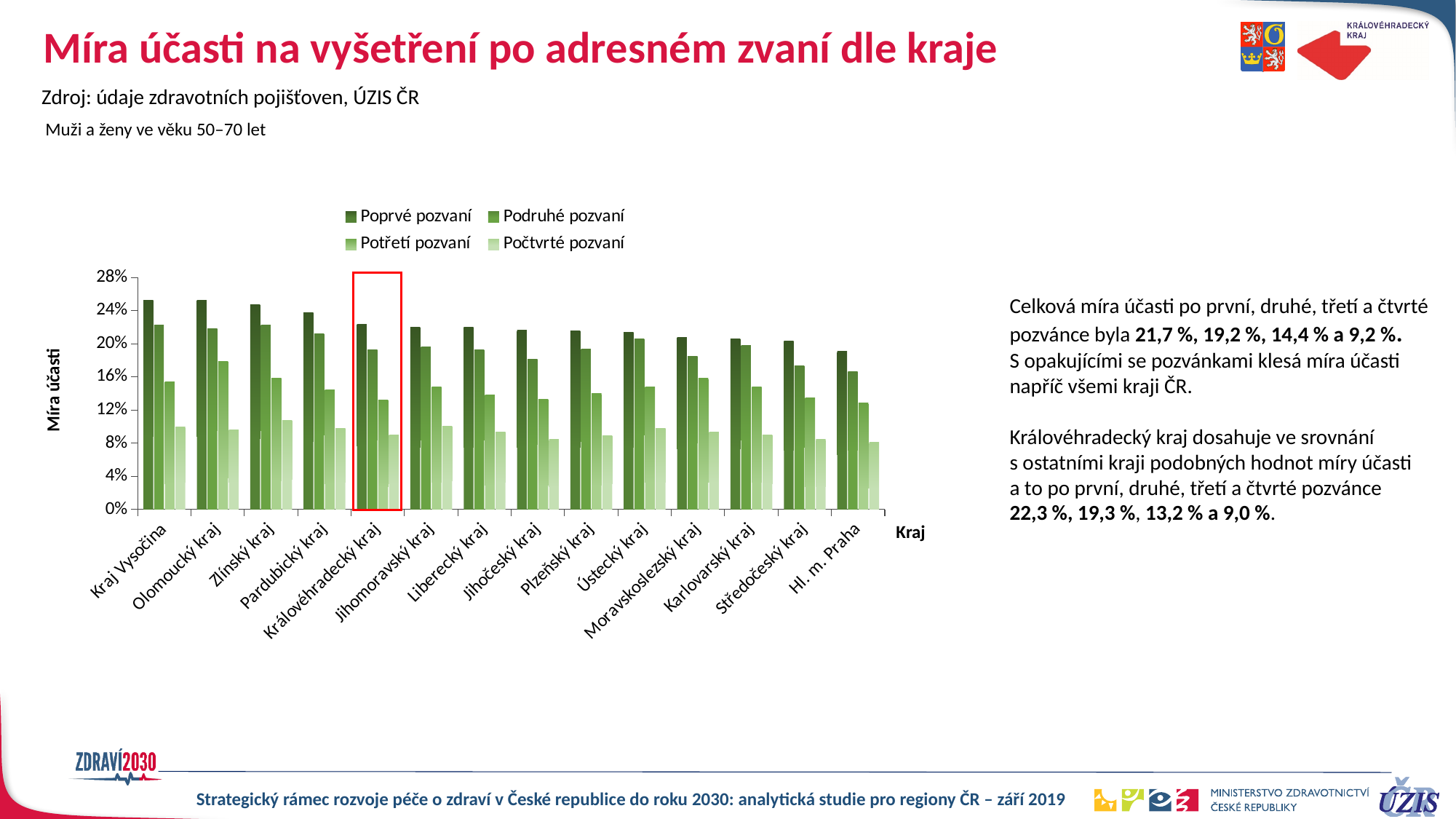
Which region has the highest value for Počtvrté pozvaní? Zlínský kraj According to the text on the slide, what is the participation rate for Královéhradecký kraj after the first invitation (Poprvé pozvaní)? 22,3 % Which region's bars are highlighted with a red box on the chart? Královéhradecký kraj Which is larger, the Potřetí pozvaní value for Kraj Vysočina or for Olomoucký kraj? Olomoucký kraj Do the Poprvé pozvaní values generally rise or fall from left to right along the x axis? fall Which region has the lowest value for Poprvé pozvaní? Hl. m. Praha Is the Poprvé pozvaní value for Kraj Vysočina greater or less than 24%? greater How many series does the legend list? 4 How many regions (kraje) are shown on the x axis? 14 Is the Poprvé pozvaní value for Hl. m. Praha greater or less than 20%? less Is the Potřetí pozvaní value for Kraj Vysočina greater or less than 16%? less What kind of chart is shown on the slide? bar chart